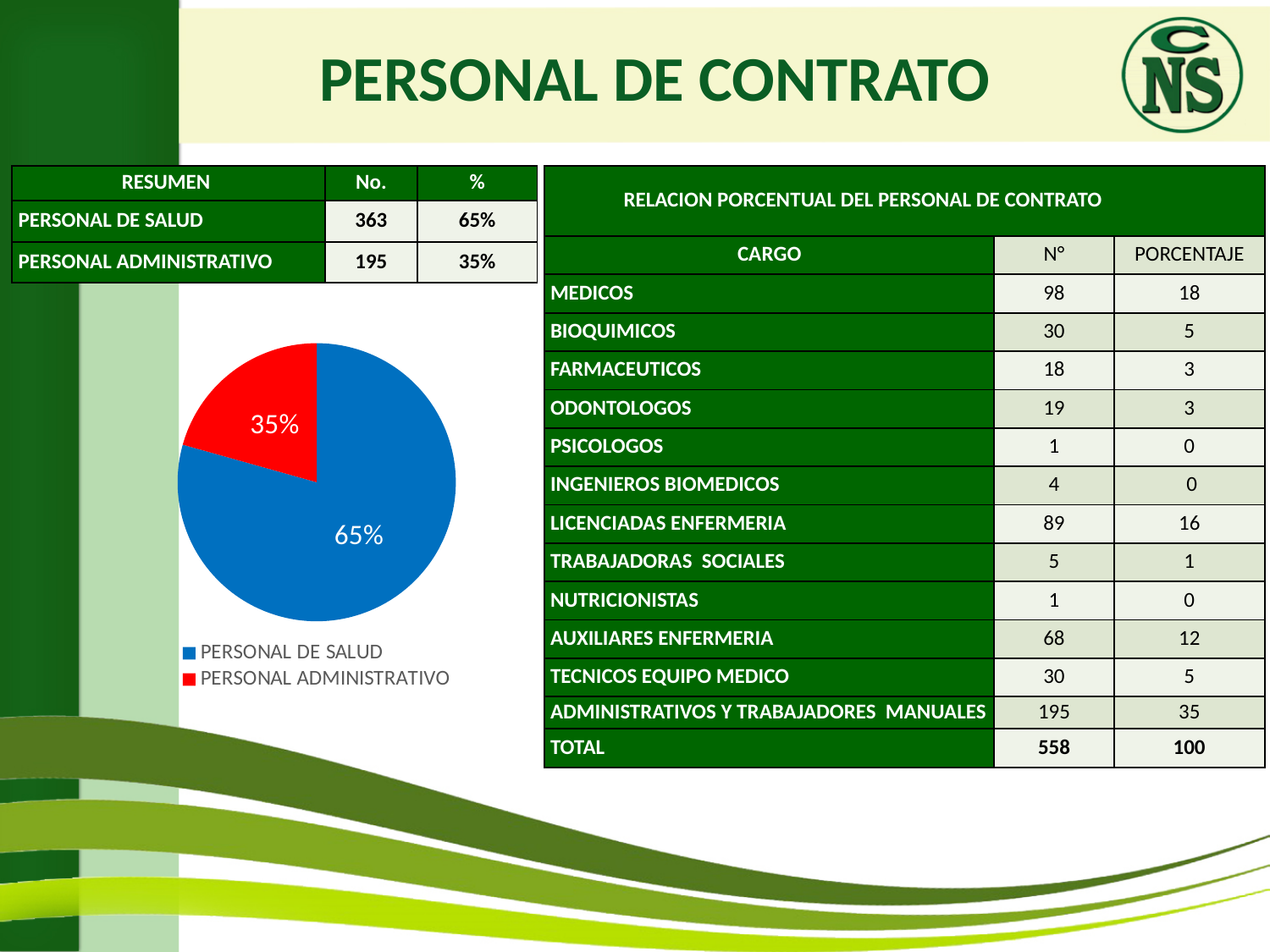
How many entries does the pie chart's legend list? 2 In the pie chart, what share does PERSONAL ADMINISTRATIVO have? 35% What is the difference in percentage points between the PERSONAL DE SALUD slice and the PERSONAL ADMINISTRATIVO slice? 30 Which slice of the pie chart is the smallest? PERSONAL ADMINISTRATIVO What colour is the PERSONAL DE SALUD slice in the pie chart? blue What colour is the PERSONAL ADMINISTRATIVO slice in the pie chart? red Which slice of the pie chart is the largest? PERSONAL DE SALUD Which is larger in the pie chart, PERSONAL DE SALUD or PERSONAL ADMINISTRATIVO? PERSONAL DE SALUD How many slices does the pie chart have? 2 In the pie chart, what share does PERSONAL DE SALUD have? 65% What kind of chart is shown on the slide? pie chart